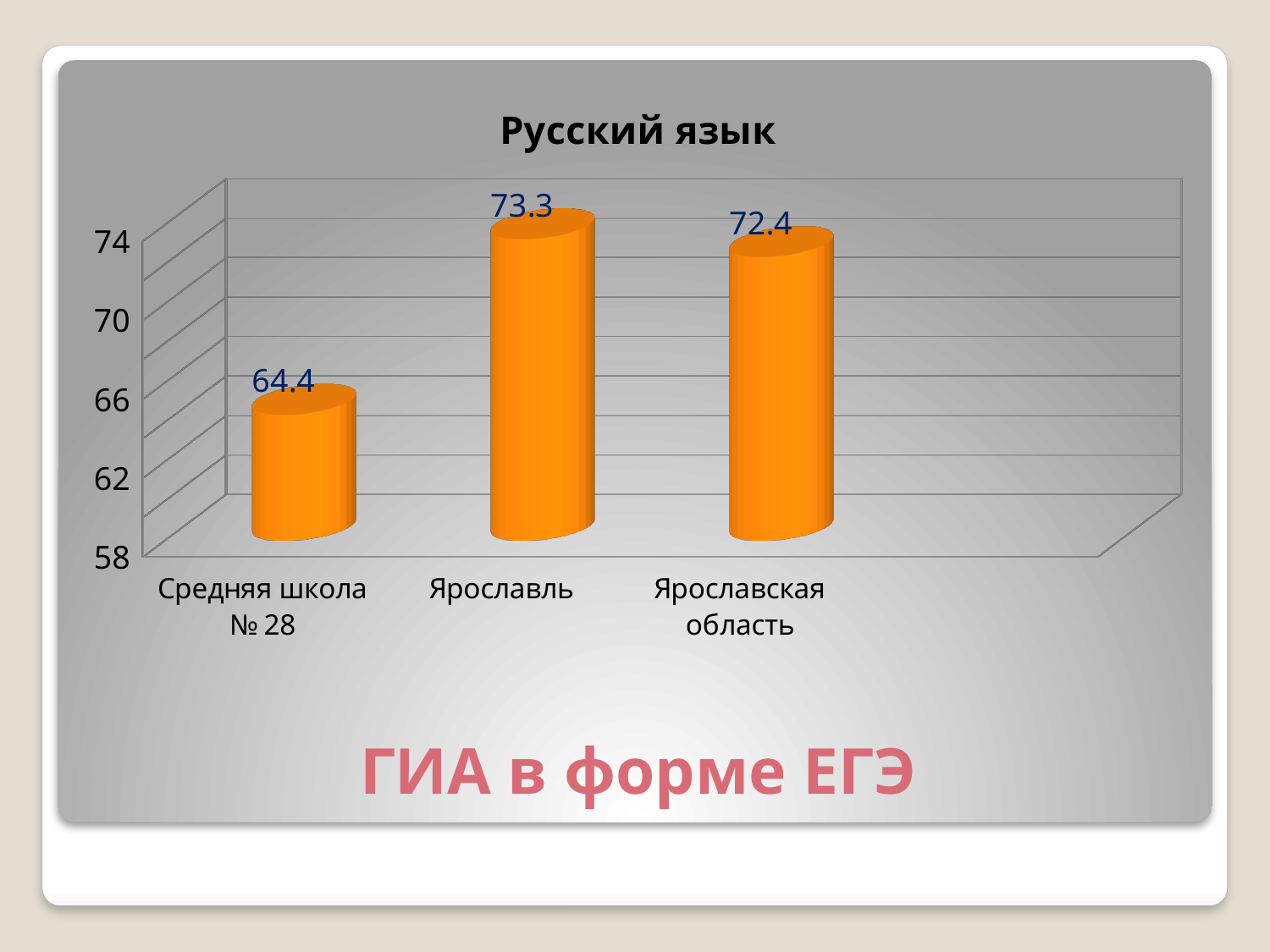
Which is larger, the value for Ярославль or the value for Средняя школа № 28? Ярославль Which category has the highest value? Ярославль What is the value for Ярославская область? 72.4 What is the difference between the values for Ярославская область and Средняя школа № 28? 8 What is the value for Ярославль? 73.3 What is the title of the chart? Русский язык How many categories are shown on the chart? 3 What is the value for Средняя школа № 28? 64.4 Is the value for Средняя школа № 28 greater or less than 66? less What kind of chart is shown on the slide? bar chart Which category has the lowest value? Средняя школа № 28 What is the difference between the values for Ярославль and Средняя школа № 28? 8.9